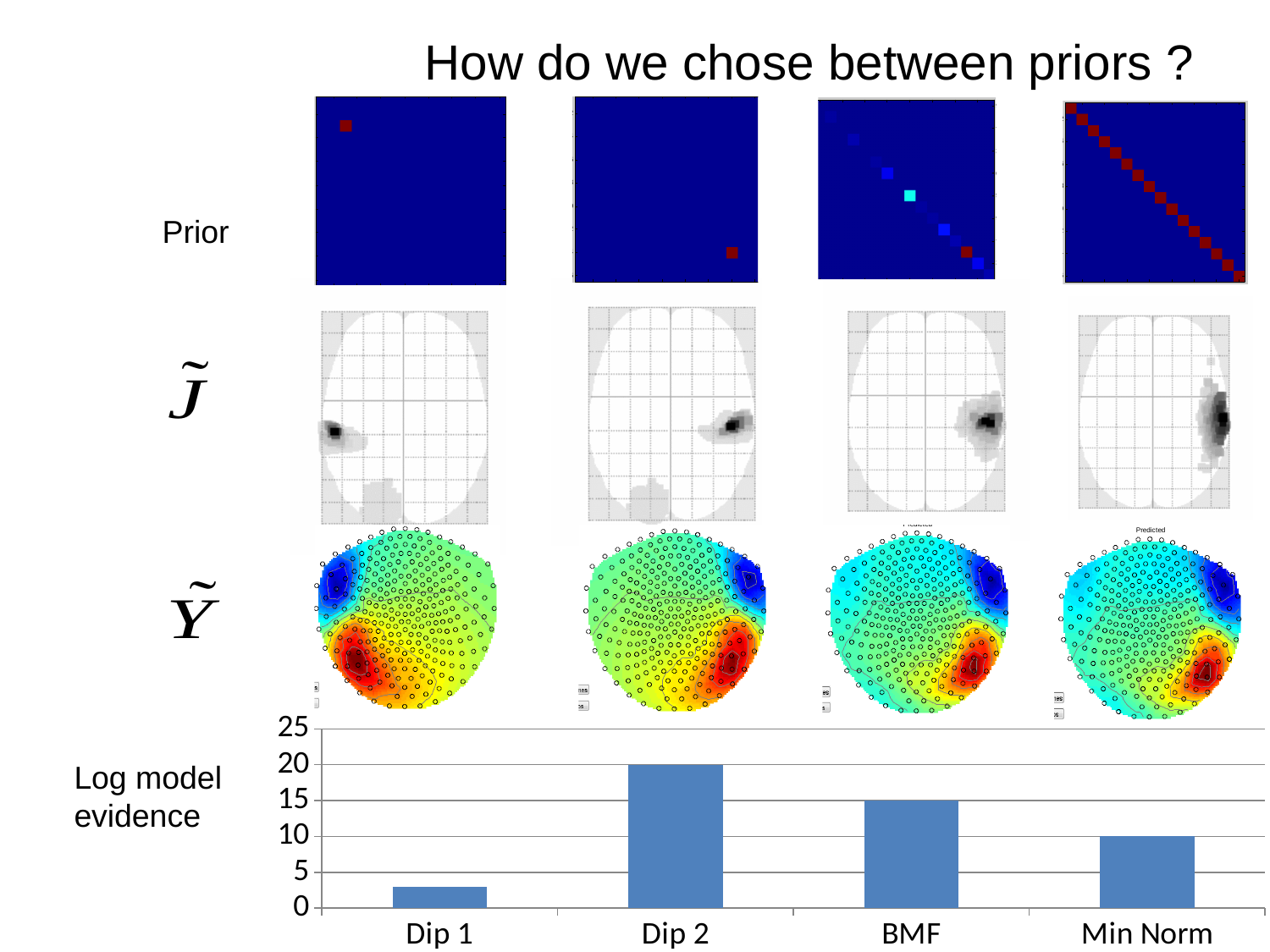
How many categories are shown on the x axis of the bar chart? 4 What kind of chart is shown at the bottom of the slide? bar chart What is the log model evidence for Min Norm? 10 What is the label on the y axis of the bar chart? Log model evidence What is the difference in log model evidence between Dip 2 and BMF? 5 Is the log model evidence for Dip 1 greater or less than 5? less Which category has the highest log model evidence? Dip 2 What is the log model evidence for BMF? 15 Which category has the lowest log model evidence? Dip 1 What is the difference in log model evidence between Dip 2 and Min Norm? 10 What is the log model evidence for Dip 2? 20 Which has a larger log model evidence, BMF or Min Norm? BMF